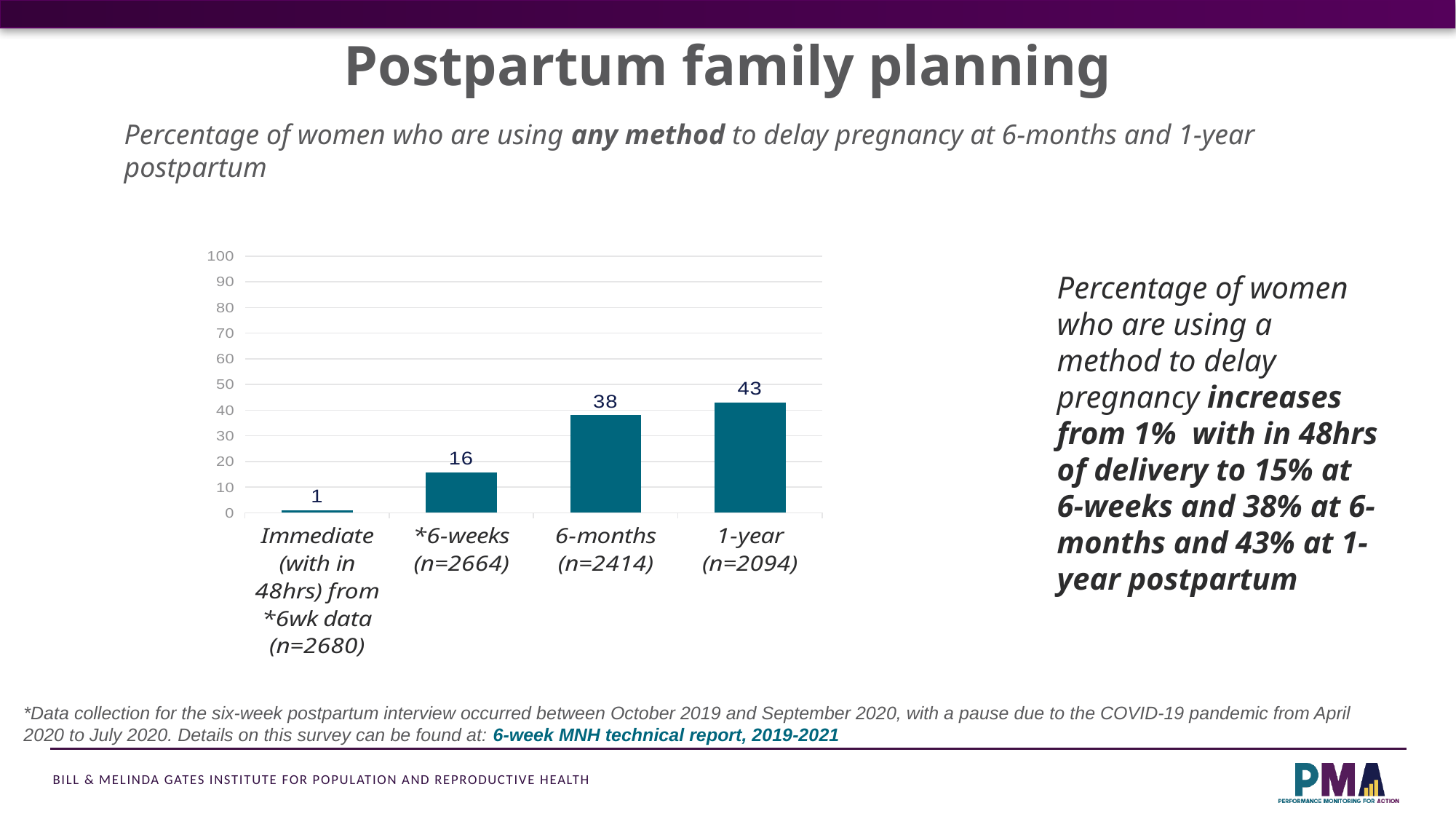
What kind of chart is shown on the slide? Bar chart Which category has the highest value? 1-year (n=2094) Which category has the lowest value? Immediate (with in 48hrs) from *6wk data (n=2680) Do the values rise or fall from left to right along the x axis? Rise What is the value for 1-year (n=2094)? 43 What is the difference between the *6-weeks and Immediate values? 15 What is the value for the Immediate (with in 48hrs) category? 1 What is the value for 6-months (n=2414)? 38 What is the value for *6-weeks (n=2664)? 16 Which is larger, the value for *6-weeks or the value for 6-months? 6-months What is the difference between the 1-year and 6-months values? 5 How many categories are shown on the x axis? 4